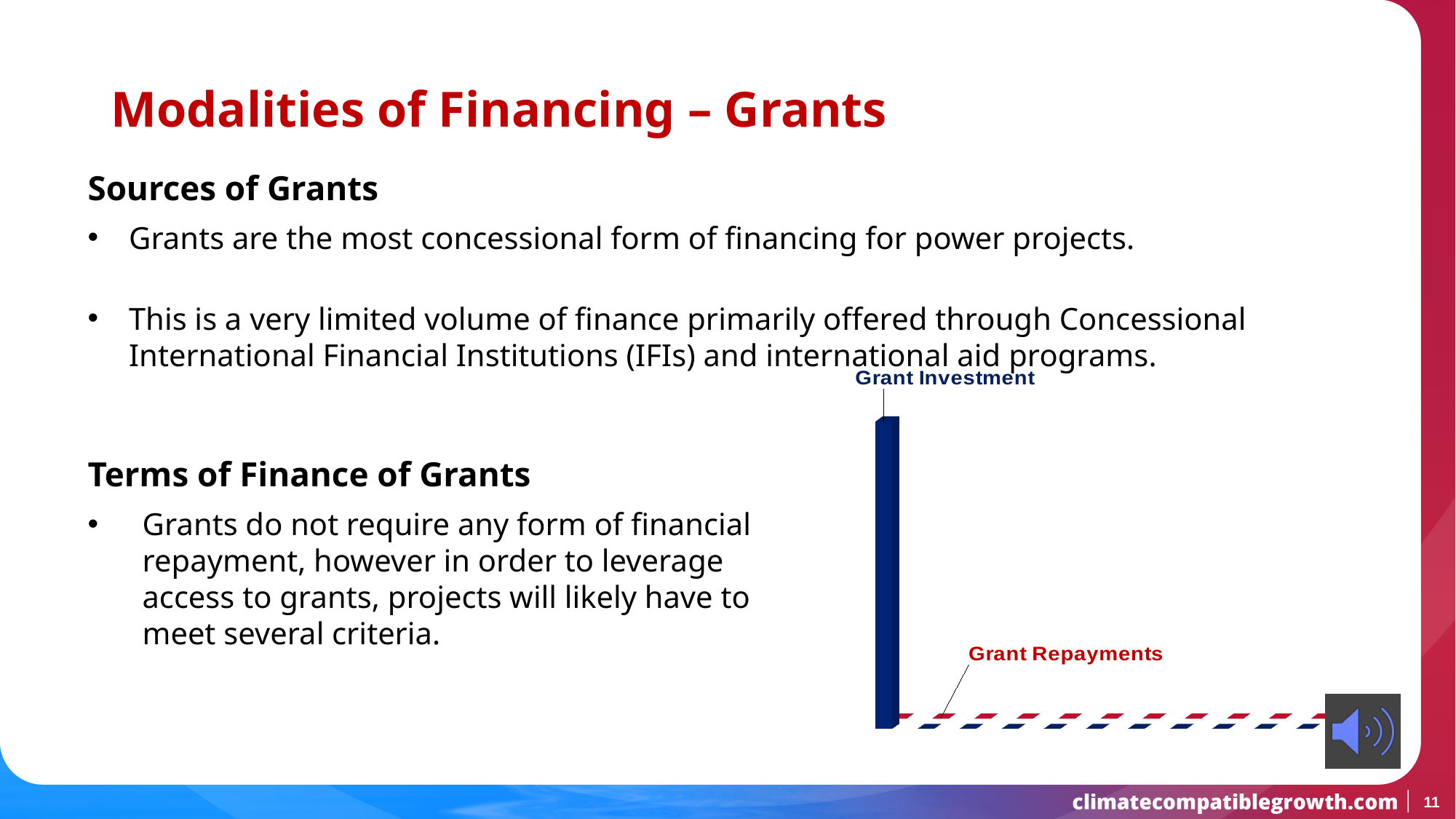
Do the Grant Repayments rise, fall, or stay flat along the x axis? stay flat What label is attached to the tall bar in the chart? Grant Investment What kind of chart is shown on the slide? bar chart Which is larger in the chart, Grant Investment or Grant Repayments? Grant Investment How many bars are plotted in the chart? 1 What label is attached to the dashed line along the bottom of the chart? Grant Repayments